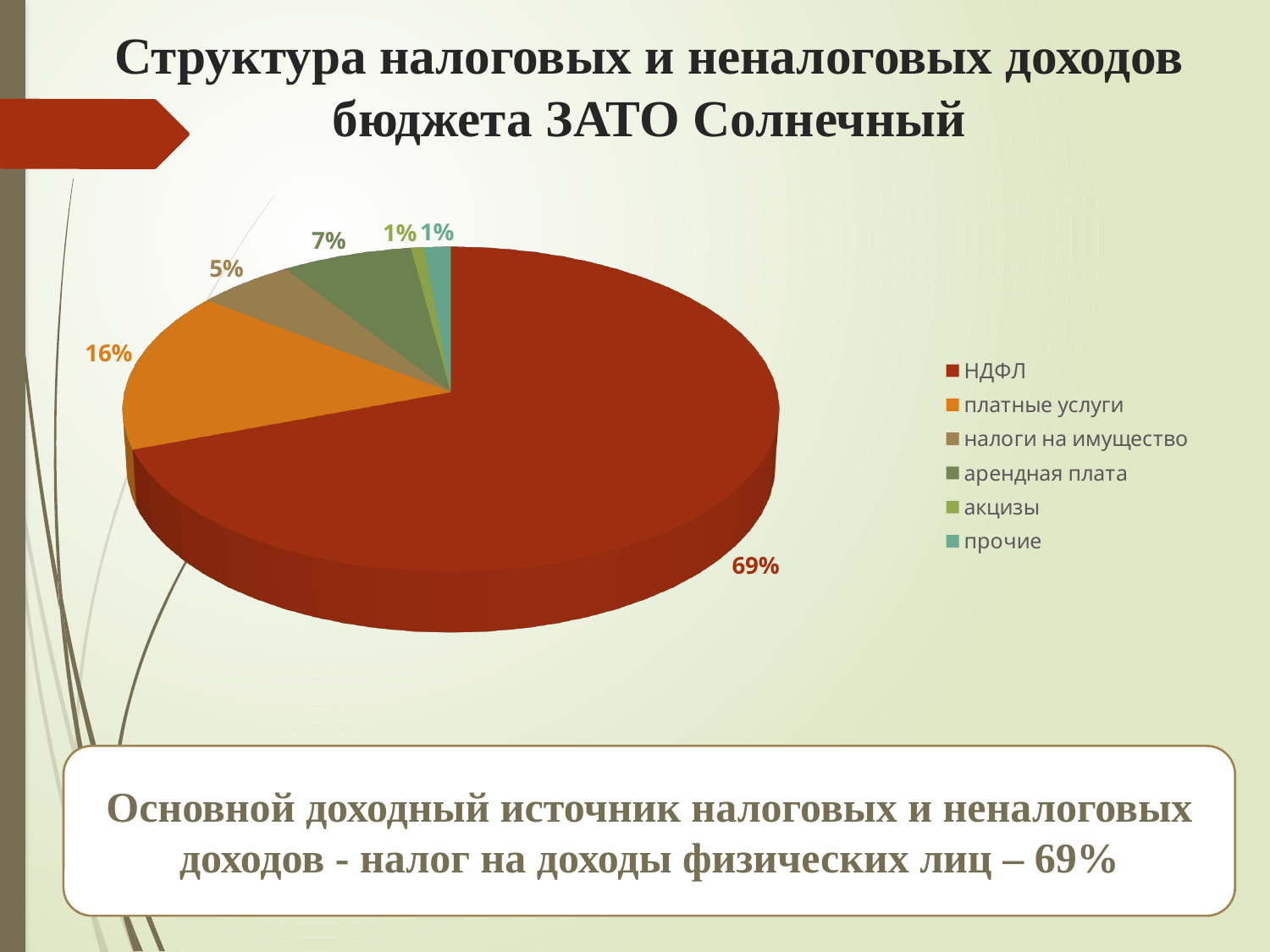
What share of the pie does НДФЛ account for? 69% What share of the pie does арендная плата account for? 7% What is the difference in percentage points between НДФЛ and платные услуги? 53 What share of the pie does акцизы account for? 1% What colour is the НДФЛ slice in the pie chart? red How many categories does the legend list? 6 Which is larger, the share for арендная плата or the share for налоги на имущество? арендная плата What is the combined share of акцизы and прочие? 2% What share of the pie does налоги на имущество account for? 5% Which category has the largest share of the pie? НДФЛ What share of the pie does платные услуги account for? 16% What kind of chart is shown on the slide? pie chart